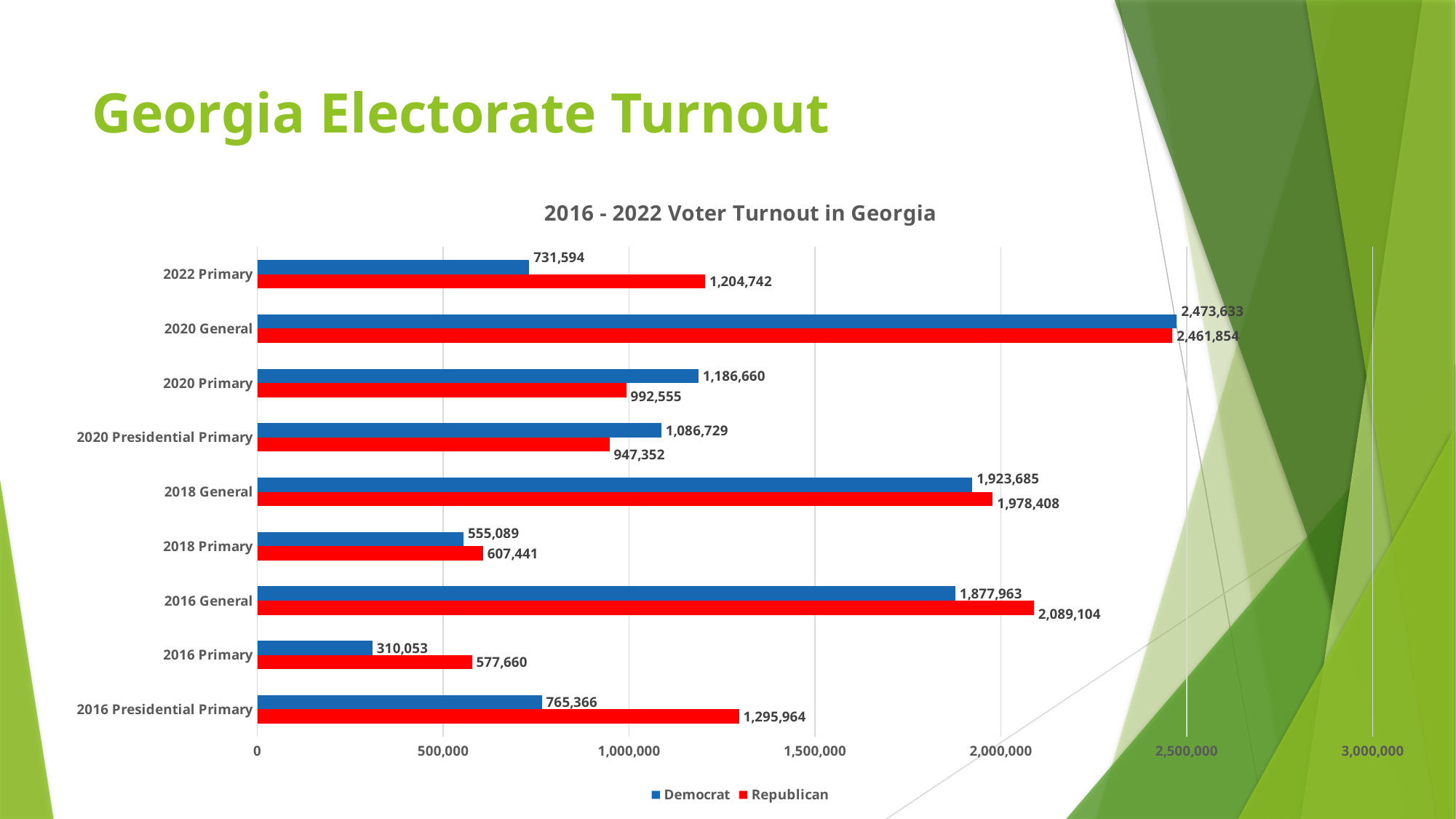
What is the Republican turnout for the 2020 Presidential Primary? 947,352 What type of chart is shown on the slide? Bar chart How many elections are shown on the chart? 9 Is the Democrat turnout for the 2016 Presidential Primary greater or less than 500,000? greater Which election has the lowest Democrat turnout? 2016 Primary What is the Democrat turnout for the 2022 Primary? 731,594 How much higher is the Republican turnout than the Democrat turnout in the 2016 Primary? 267,607 How many series does the legend list? 2 In the 2018 General, which party had the larger turnout? Republican Which election has the lowest Republican turnout? 2016 Primary Which election has the highest Democrat turnout? 2020 General What is the Republican turnout for the 2016 General? 2,089,104